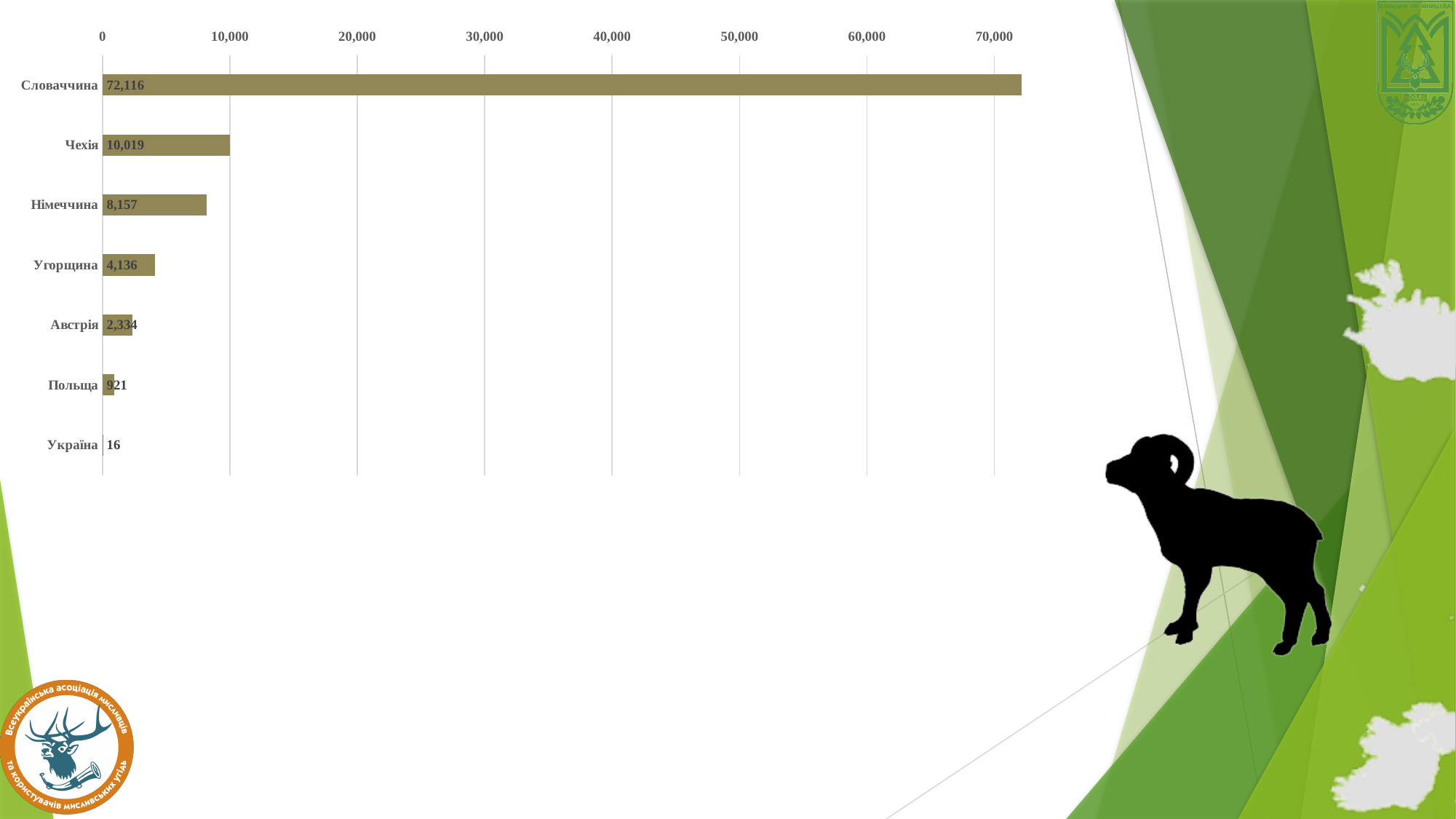
How many categories are shown in the chart? 7 Is the value for Словаччина greater or less than 70,000? greater Which category has the lowest value? Україна What is the difference between the values for Чехія and Німеччина? 1,862 What is the value for Словаччина? 72,116 Which category has the highest value? Словаччина What is the value for Німеччина? 8,157 What is the value for Угорщина? 4,136 What kind of chart is shown on the slide? bar chart What is the value for Україна? 16 What is the value for Чехія? 10,019 Which is larger, the value for Австрія or the value for Польща? Австрія